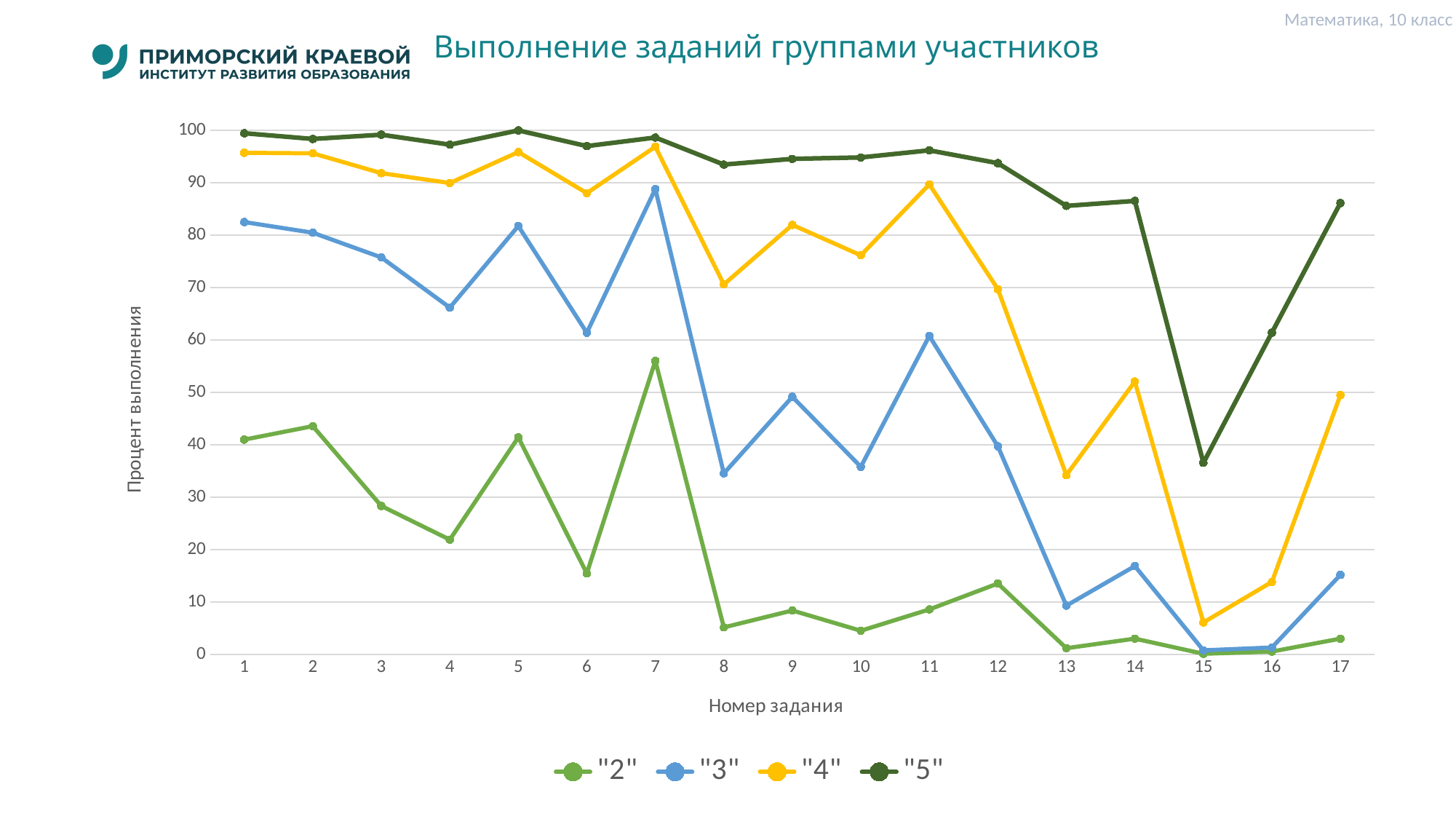
At task 7, which series has the larger value, "3" or "4"? "4" Is the value for series "2" at task 7 greater or less than 50? greater Is the value for series "4" at task 15 greater or less than 10? less How many series does the legend list? 4 How many task numbers are plotted along the x axis? 17 What kind of chart is shown on the slide? line chart Is the value for series "5" at task 15 greater or less than 50? less At task 14, which series has the larger value, "2" or "3"? "3" For series "5", at which task number is the value lowest? 15 What is the title of the chart? Выполнение заданий группами участников For series "2", at which task number is the value highest? 7